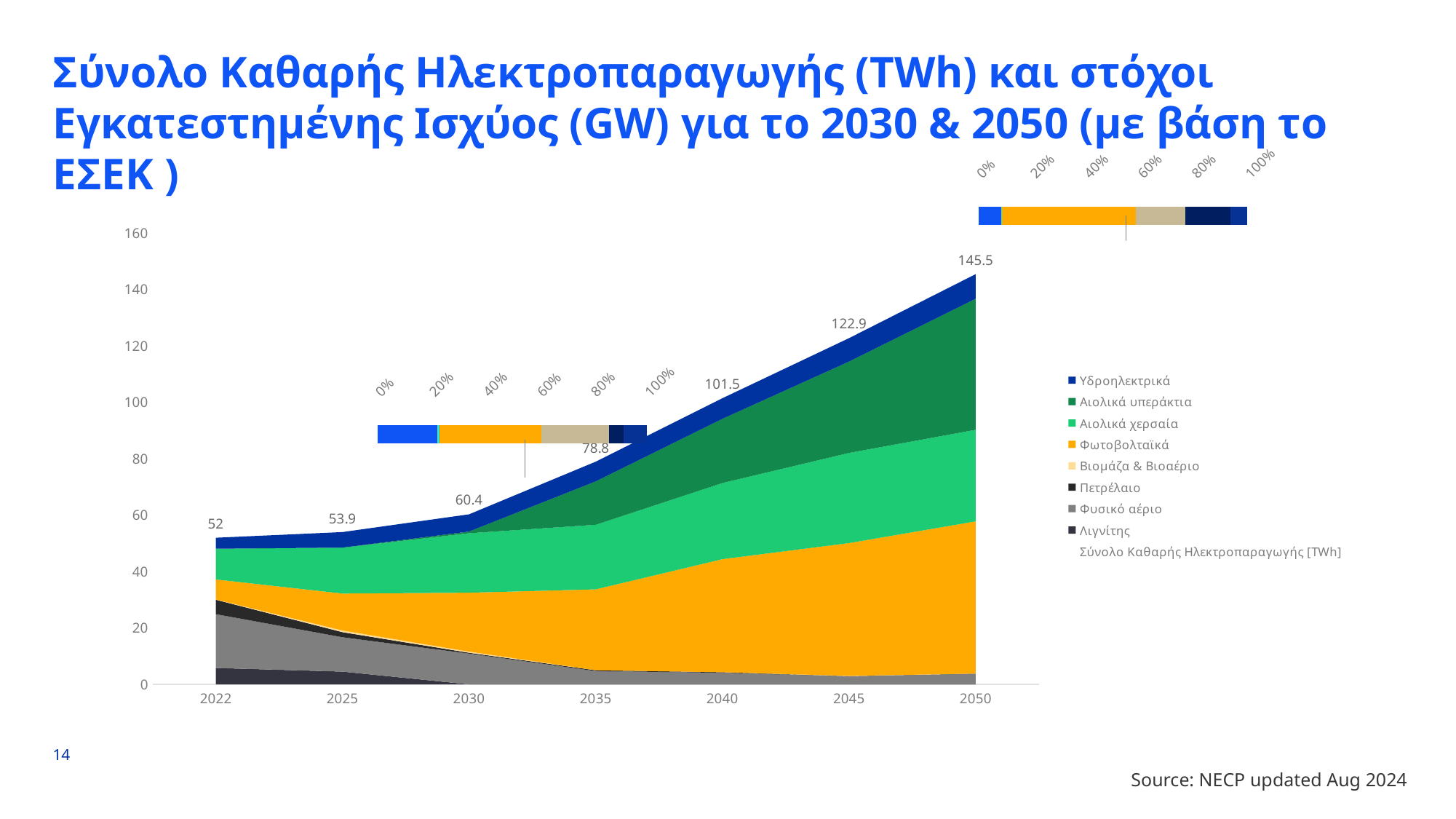
How many entries does the legend of the main chart list? 9 What is the total net electricity generation value labelled for 2035? 78.8 Which year has the lowest labelled total net electricity generation? 2022 What is the difference between the labelled totals for 2050 and 2022? 93.5 What is the total net electricity generation value labelled for 2022? 52 What kind of chart is the main chart on the slide? Stacked area chart How many years are shown on the x axis of the main chart? 7 What is the difference between the labelled totals for 2035 and 2030? 18.4 Does the total net electricity generation rise or fall from 2022 to 2050? Rise Which year has a larger labelled total, 2040 or 2045? 2045 Which year has the highest labelled total net electricity generation? 2050 What is the total net electricity generation value labelled for 2050? 145.5